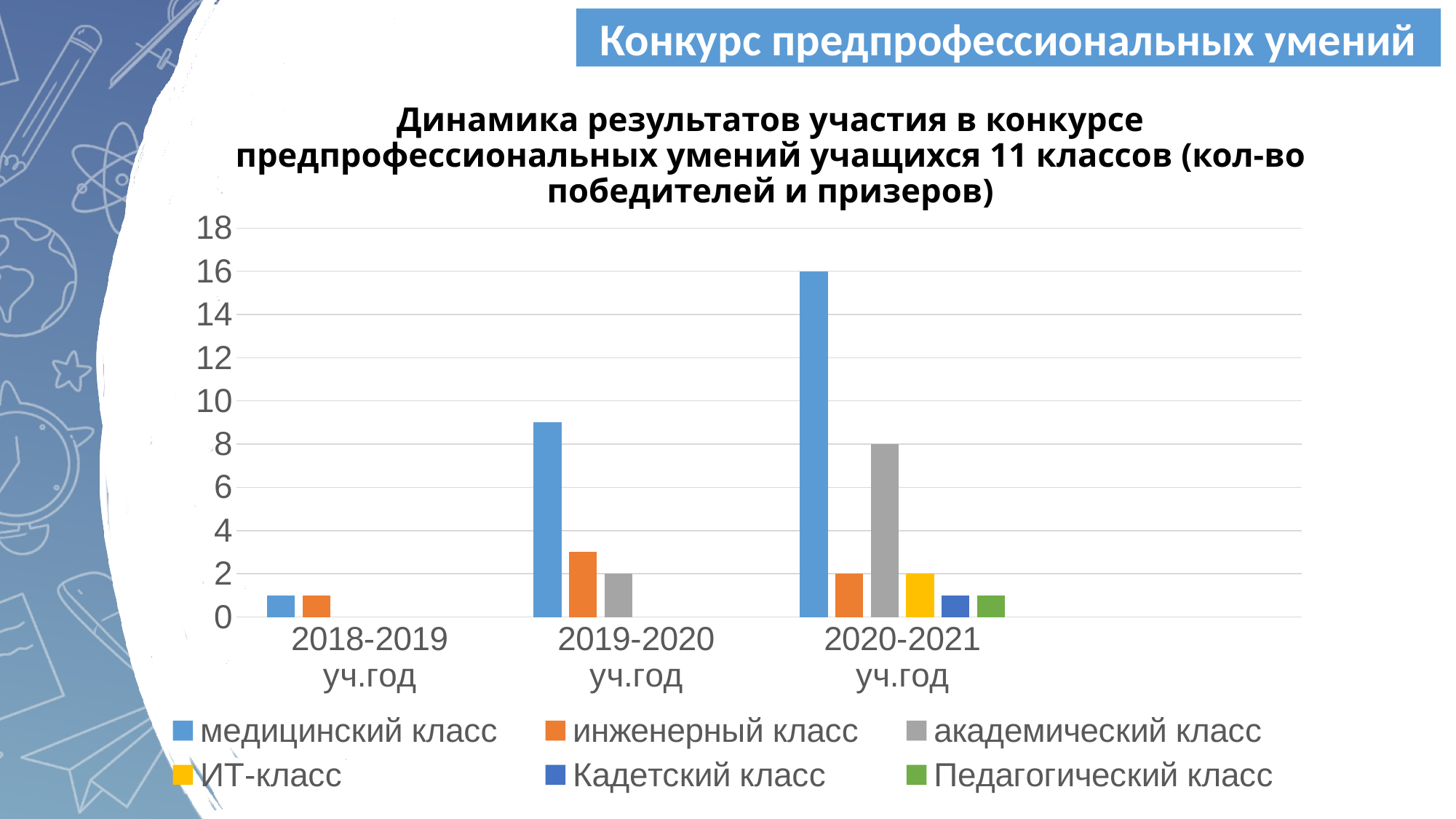
How many academic-year categories are shown on the x axis? 3 What is the difference between медицинский класс and академический класс in 2020-2021 уч.год? 8 Is the value for инженерный класс in 2019-2020 уч.год greater or less than 4? less What is the value for ИТ-класс in 2020-2021 уч.год? 2 How many series does the legend list? 6 Is the value for медицинский класс in 2019-2020 уч.год greater or less than 10? less What is the value for академический класс in 2020-2021 уч.год? 8 In which academic year does медицинский класс have its highest value? 2020-2021 уч.год Does the value for медицинский класс rise or fall from 2018-2019 уч.год to 2020-2021 уч.год? rise What is the value for медицинский класс in 2020-2021 уч.год? 16 What kind of chart is shown on the slide? bar chart What is the value for академический класс in 2019-2020 уч.год? 2